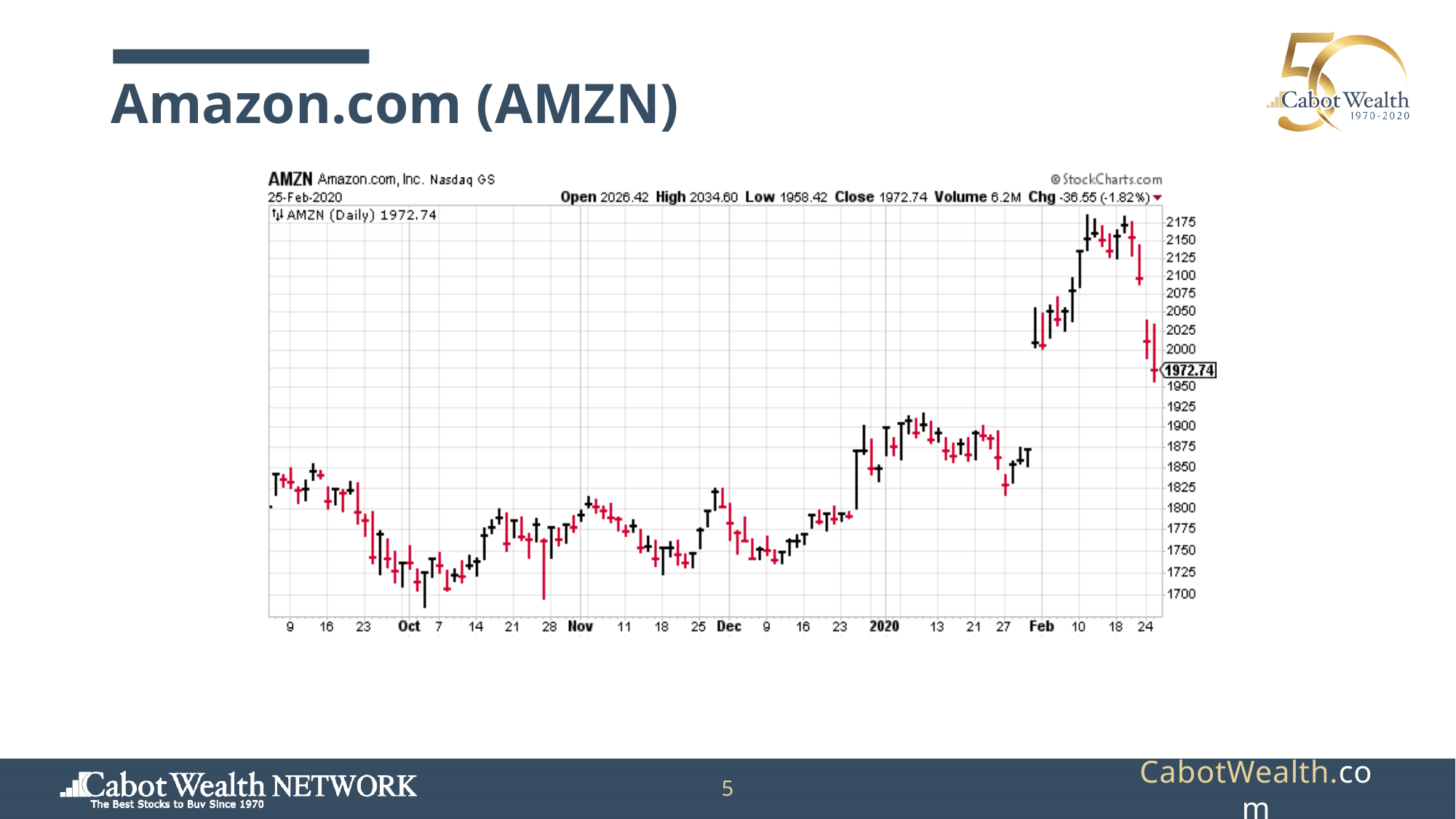
Which is higher: the price in early February or the price in early October? early February What is the difference between the High and Low values shown in the chart header? 76.18 What is the opening price shown in the chart header for 25-Feb-2020? 2026.42 What percentage change is shown in the chart header for 25-Feb-2020? -1.82% What is the closing price shown for AMZN on 25-Feb-2020? 1972.74 What volume is shown in the chart header? 6.2M Overall, does the AMZN price rise or fall from October to February along the x axis? rise Is the highest price reached in February greater or less than 2150? greater What is the Low value shown in the chart header? 1958.42 Is the lowest price reached in early October greater or less than 1725? less What is the High value shown in the chart header? 2034.60 What is the date shown at the top of the chart? 25-Feb-2020